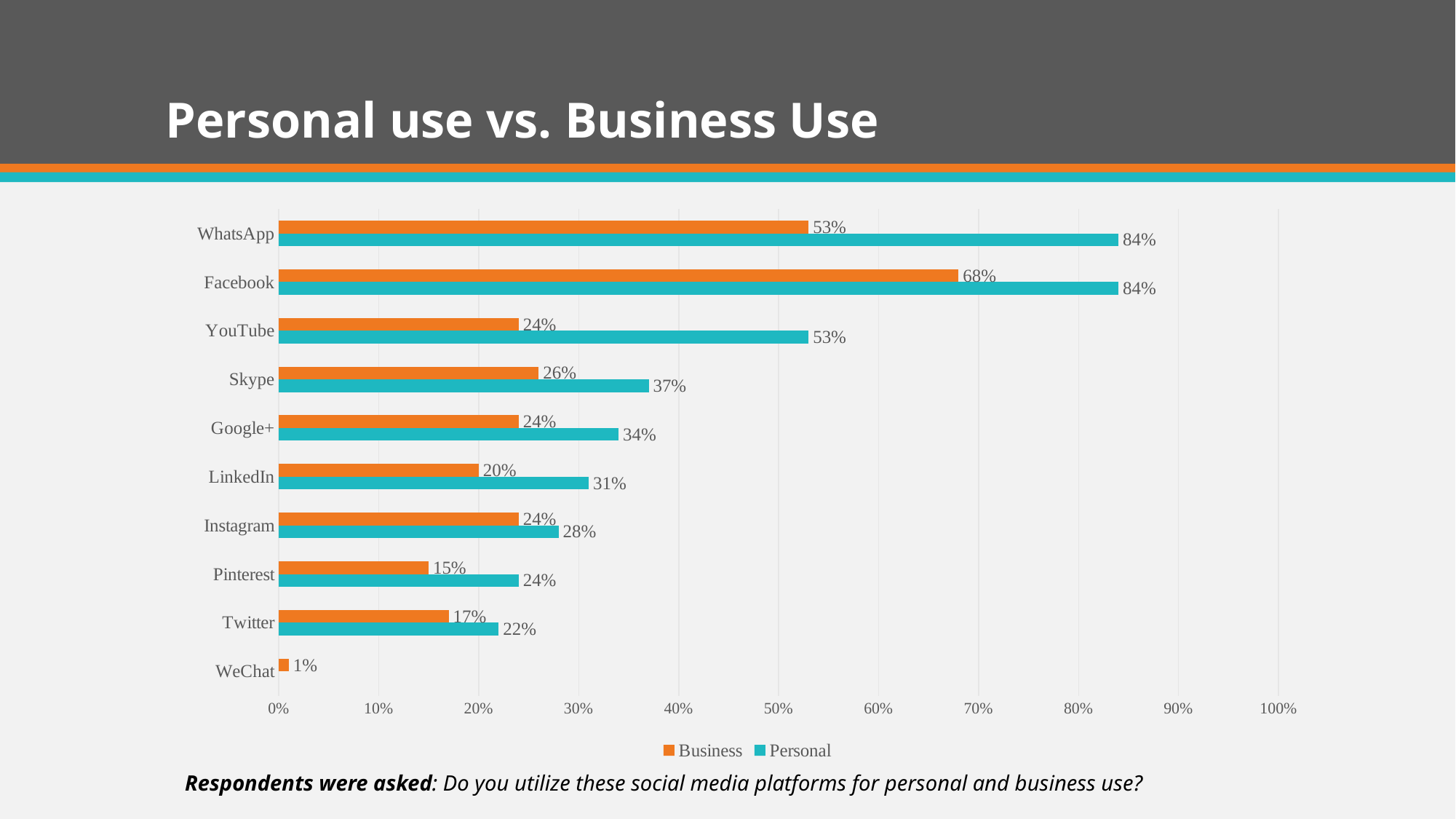
What is the difference between the Personal and Business values for YouTube? 29% How many series does the legend list? 2 What is the Personal value for Skype? 37% How many platforms are listed on the chart? 10 What is the Personal value for WhatsApp? 84% Which platform has the lowest Business value? WeChat Which is larger, the Business value for Skype or the Business value for Twitter? Skype What is the Business value for WeChat? 1% What is the Business value for Facebook? 68% What kind of chart is shown on the slide? Bar chart Which platform has the highest Business value? Facebook Which colour represents the Personal series? Teal